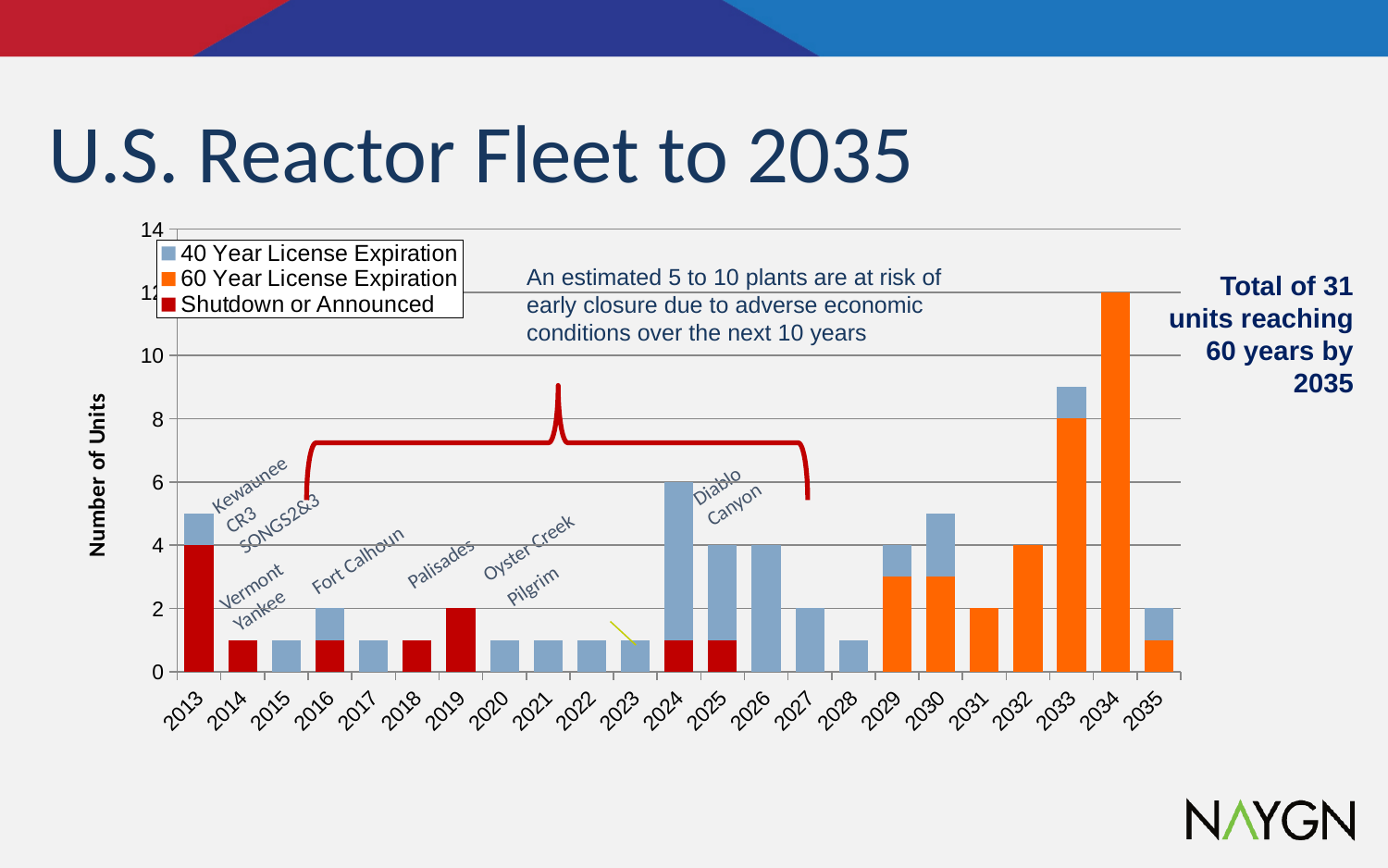
What is the total number of units for 2034? 12 What is the title of the chart on the slide? U.S. Reactor Fleet to 2035 Is the total number of units for 2033 greater or less than 8? greater Which year has the highest total number of units? 2034 How many years are shown along the x axis? 23 What kind of chart is shown on the slide? Stacked bar chart Which colour represents the '60 Year License Expiration' series in the legend? Orange What is the difference between the total units in 2034 and 2024? 6 What is the total number of units for 2024? 6 How many series does the legend list? 3 What is the number of units for 2027? 2 Which year has more units, 2034 or 2033? 2034